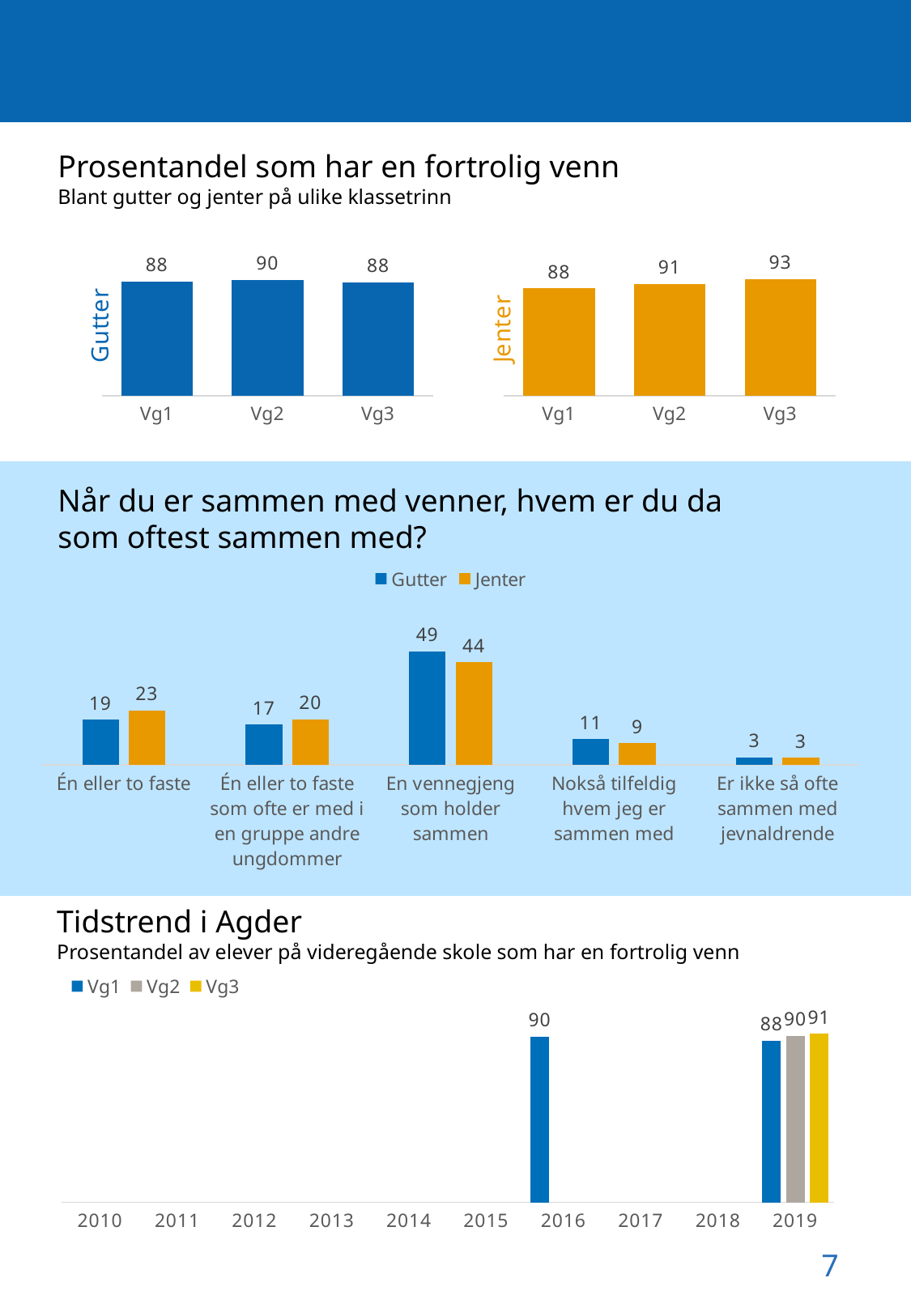
In the 'Når du er sammen med venner' chart, how many series does the legend list? 2 In the 'Prosentandel som har en fortrolig venn' chart, what is the value for Gutter in Vg2? 90 In the 'Tidstrend i Agder' chart, what is the value for Vg1 in 2016? 90 What kind of chart is the 'Tidstrend i Agder' chart? bar chart In the 'Prosentandel som har en fortrolig venn' chart, do the Jenter values rise or fall from Vg1 to Vg3? rise In the 'Tidstrend i Agder' chart, which series has the highest value in 2019? Vg3 In the 'Når du er sammen med venner' chart, what is the difference between Jenter and Gutter for 'Én eller to faste'? 4 In the 'Prosentandel som har en fortrolig venn' chart, which class level has the highest value for Jenter? Vg3 In the 'Prosentandel som har en fortrolig venn' chart, what is the value for Jenter in Vg3? 93 In the 'Når du er sammen med venner' chart, which category has the lowest value for Jenter? Er ikke så ofte sammen med jevnaldrende In the 'Når du er sammen med venner' chart, what is the value for Gutter in 'En vennegjeng som holder sammen'? 49 In the 'Når du er sammen med venner' chart, how many categories are shown on the x axis? 5